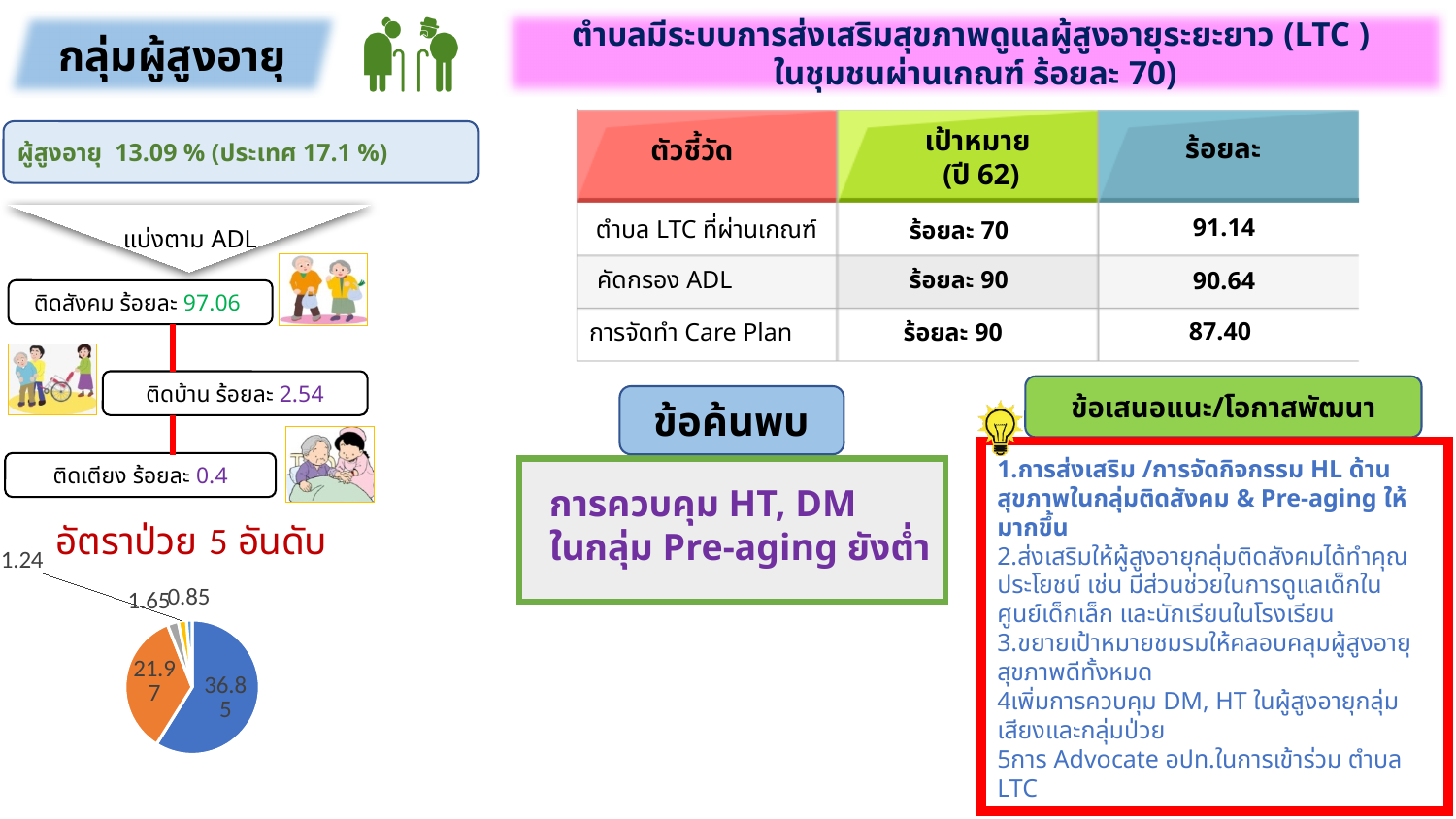
In the pie chart อัตราป่วย 5 อันดับ, what is the difference between the labelled values 1.65 and 1.24? 0.41 What kind of chart is shown under the heading อัตราป่วย 5 อันดับ? pie chart In the pie chart อัตราป่วย 5 อันดับ, what is the difference between the two largest labelled values, 36.85 and 21.97? 14.88 What is the smallest value labelled on the pie chart อัตราป่วย 5 อันดับ? 0.85 In the pie chart อัตราป่วย 5 อันดับ, what is the value of the blue slice? 36.85 What colour is the largest slice of the pie chart อัตราป่วย 5 อันดับ? blue What is the largest value labelled on the pie chart อัตราป่วย 5 อันดับ? 36.85 How many slices does the pie chart อัตราป่วย 5 อันดับ have? 5 What is the title shown above the pie chart on the slide? อัตราป่วย 5 อันดับ In the pie chart อัตราป่วย 5 อันดับ, which slice is larger, the blue one or the orange one? the blue one In the pie chart อัตราป่วย 5 อันดับ, what is the value of the orange slice? 21.97